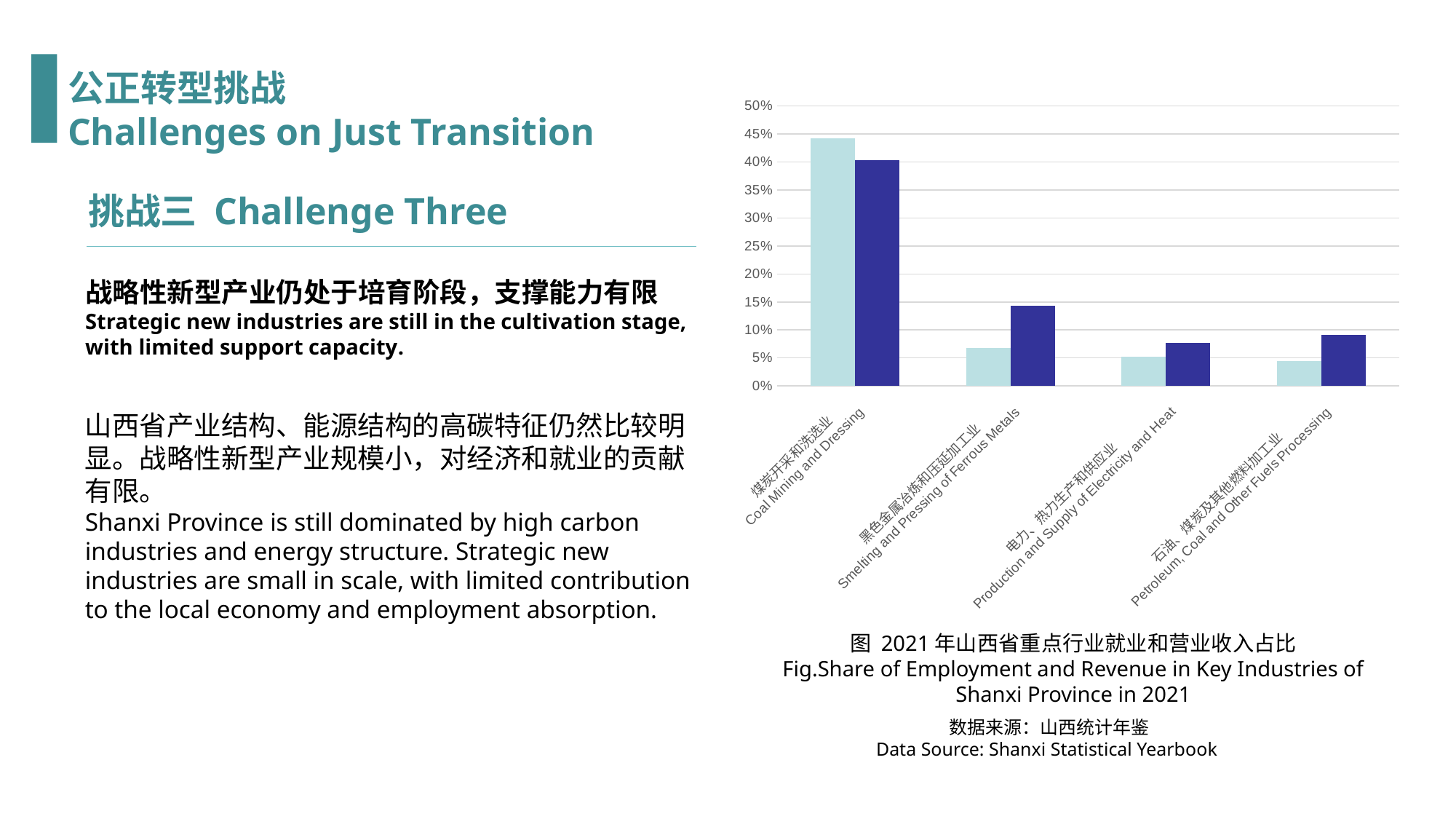
For Smelting and Pressing of Ferrous Metals, which bar is taller, the light blue or the dark blue? dark blue Do the light blue bars rise or fall from left to right across the categories? fall What kind of chart is shown on the slide? bar chart Is the light blue bar for Petroleum, Coal and Other Fuels Processing greater or less than 5%? less Is the light blue bar for Coal Mining and Dressing greater or less than 40%? greater Which category has the shortest light blue bar? Petroleum, Coal and Other Fuels Processing Which category has the shortest dark blue bar? Production and Supply of Electricity and Heat How many industry categories are shown on the x axis of the chart? 4 Which category has the tallest light blue bar? Coal Mining and Dressing Which category has the tallest dark blue bar? Coal Mining and Dressing Is the dark blue bar for Smelting and Pressing of Ferrous Metals greater or less than 10%? greater What data source is cited below the chart? Shanxi Statistical Yearbook